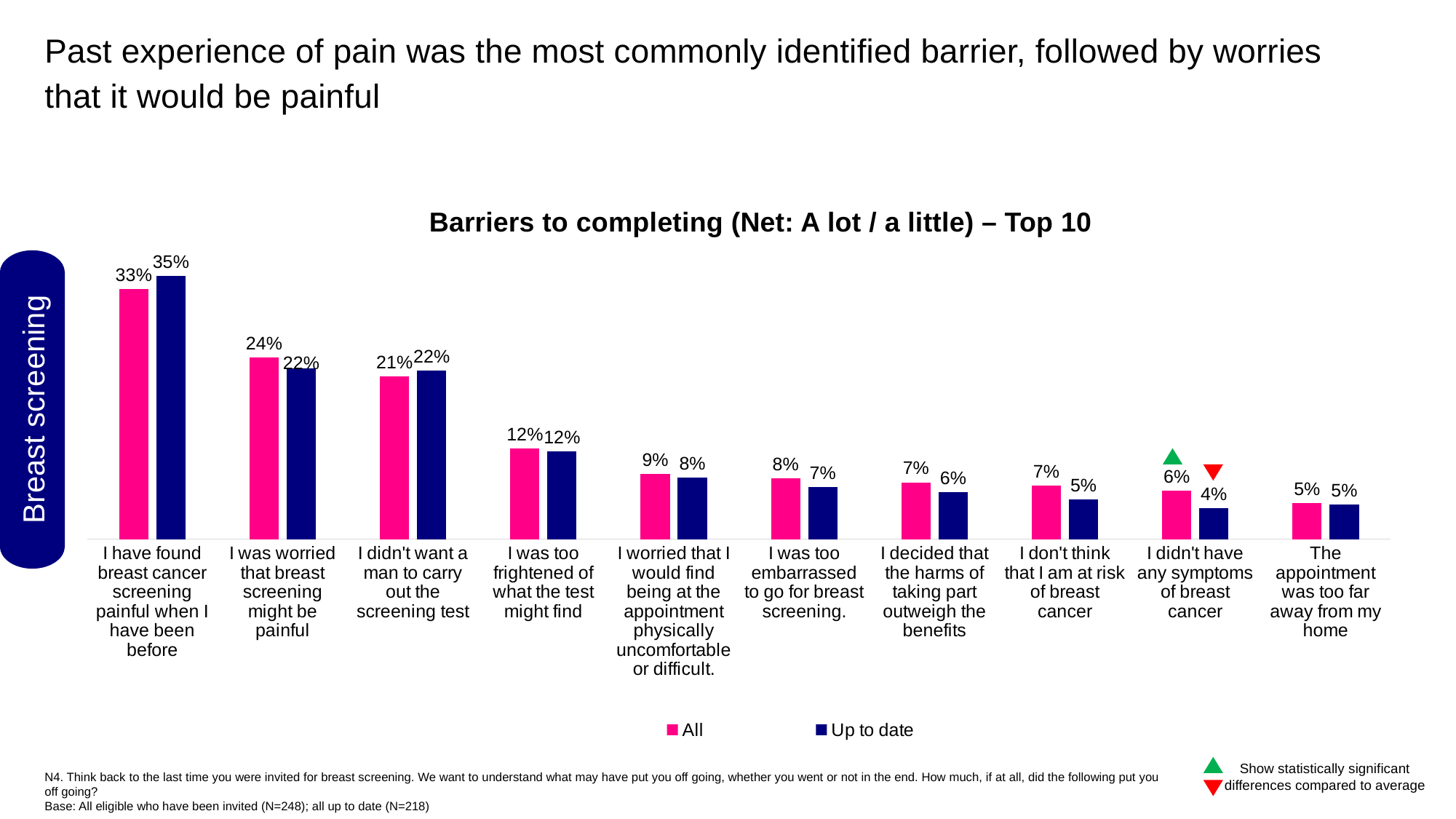
What is the difference between the 'All' and 'Up to date' values for 'I have found breast cancer screening painful when I have been before'? 2% Which category has the highest 'Up to date' value? I have found breast cancer screening painful when I have been before What is the title of the chart? Barriers to completing (Net: A lot / a little) – Top 10 What is the value for 'All' for 'I have found breast cancer screening painful when I have been before'? 33% Which category has the lowest 'Up to date' value? I didn't have any symptoms of breast cancer Which is larger for 'I was worried that breast screening might be painful': the 'All' value or the 'Up to date' value? All How many series does the legend list? 2 What is the value for 'All' for 'I didn't want a man to carry out the screening test'? 21% Do the 'All' values generally rise or fall from left to right along the x axis? Fall What kind of chart is shown on the slide? Bar chart How many categories are shown on the x axis? 10 What is the value for 'Up to date' for 'I was worried that breast screening might be painful'? 22%